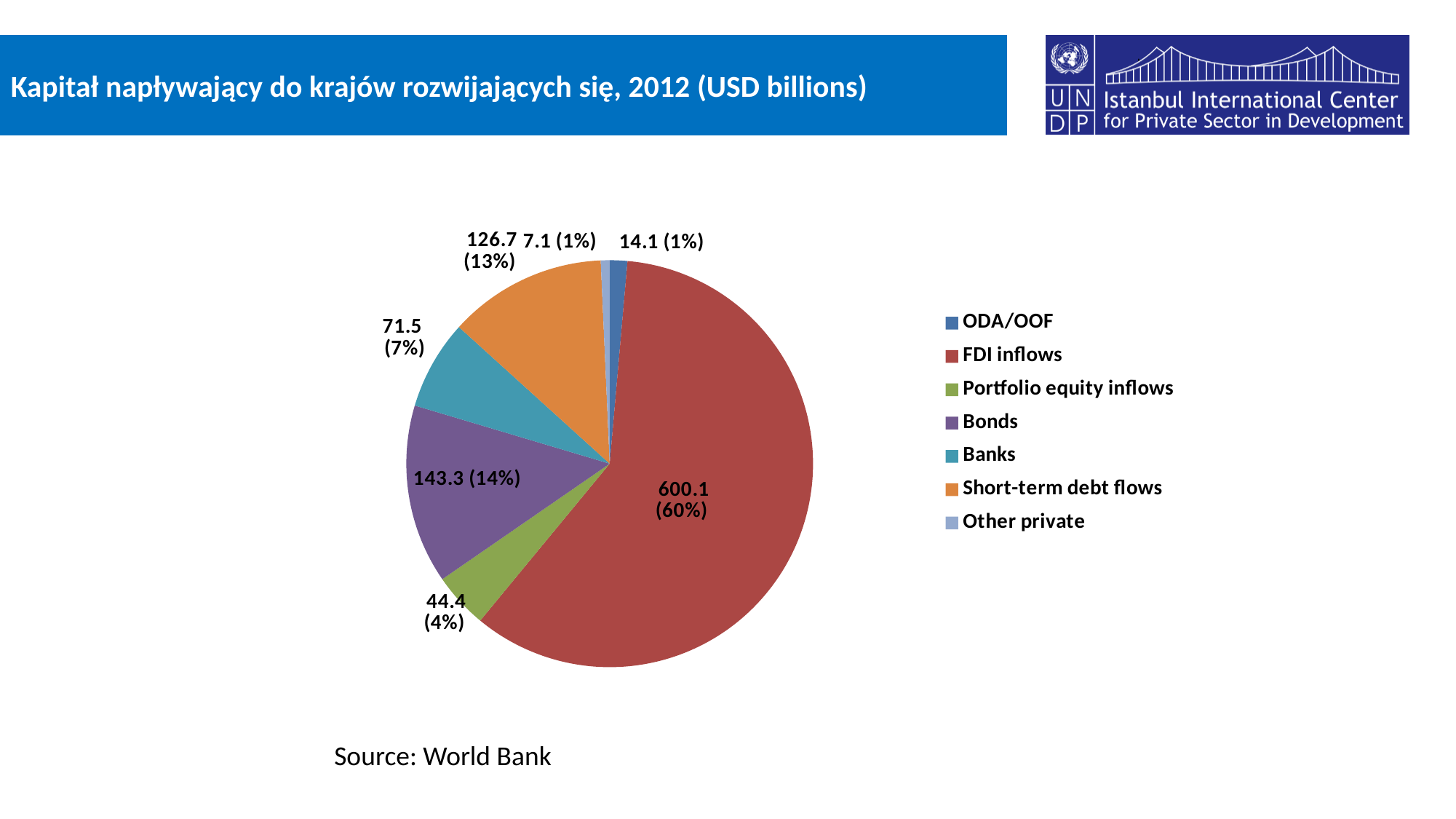
Which is larger, the value for Bonds or the value for Short-term debt flows? Bonds What is the value for Bonds? 143.3 Which category has the smallest slice of the pie? Other private Which category has the largest slice of the pie? FDI inflows How many categories does the legend list? 7 What type of chart is shown on the slide? pie chart What share of the pie does Short-term debt flows represent? 13% What is the value for FDI inflows? 600.1 What is the value for Short-term debt flows? 126.7 What is the value for Portfolio equity inflows? 44.4 What is the value for Banks? 71.5 What is the difference between the values for Bonds and Banks? 71.8